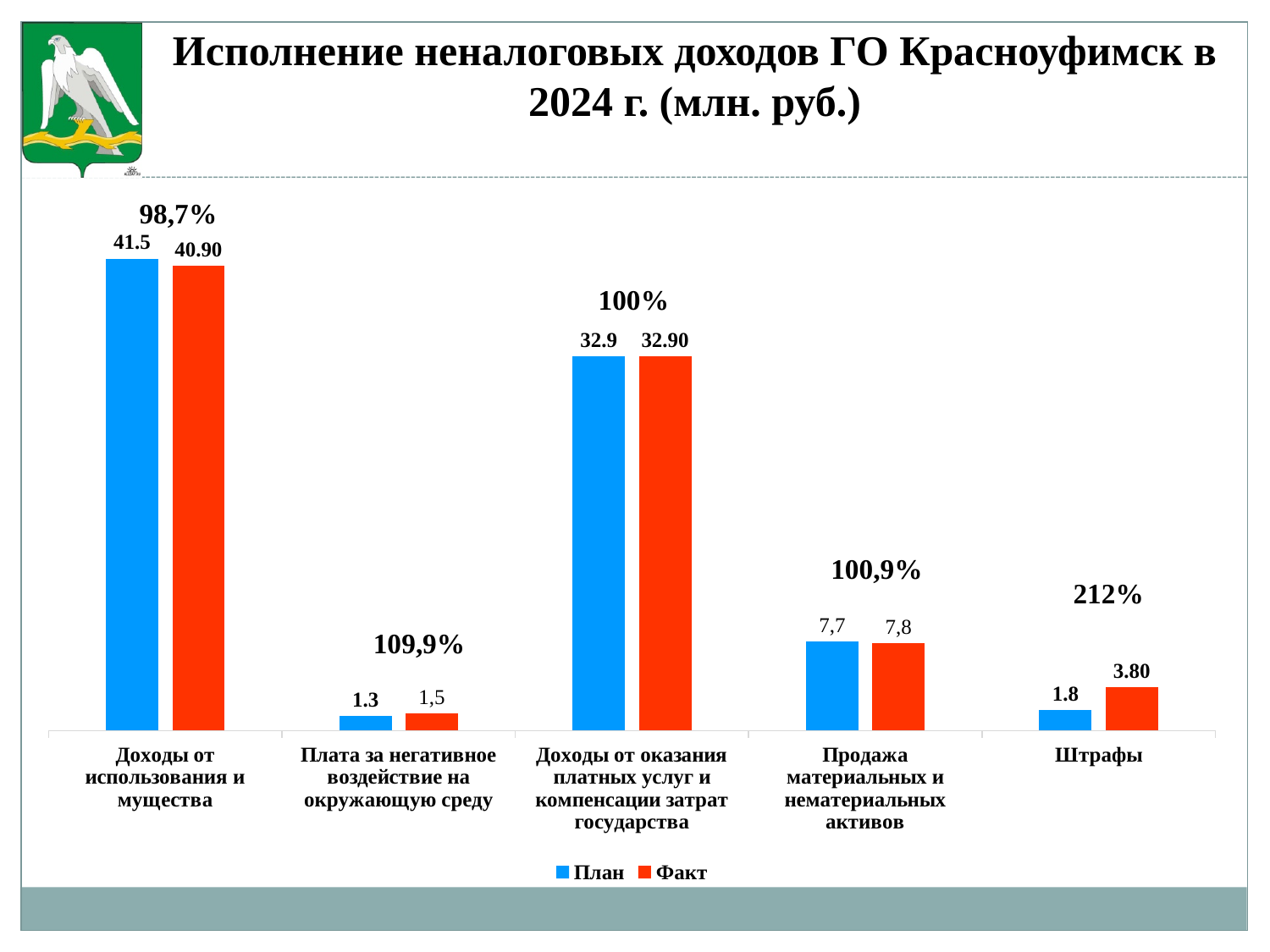
Which category has the highest План value? Доходы от использования имущества What is the Факт value for Доходы от оказания платных услуг и компенсации затрат государства? 32.90 For Доходы от использования имущества, which is larger: План or Факт? План What is the План value for Доходы от использования имущества? 41.5 What percentage of execution is shown above the bars for Штрафы? 212% How many series does the legend list? 2 What is the Факт value for Плата за негативное воздействие на окружающую среду? 1,5 For Штрафы, what is the difference between the Факт and План values? 2.0 What is the Факт value for Штрафы? 3.80 Which category has the lowest План value? Плата за негативное воздействие на окружающую среду How many categories are shown on the x axis? 5 What is the План value for Штрафы? 1.8